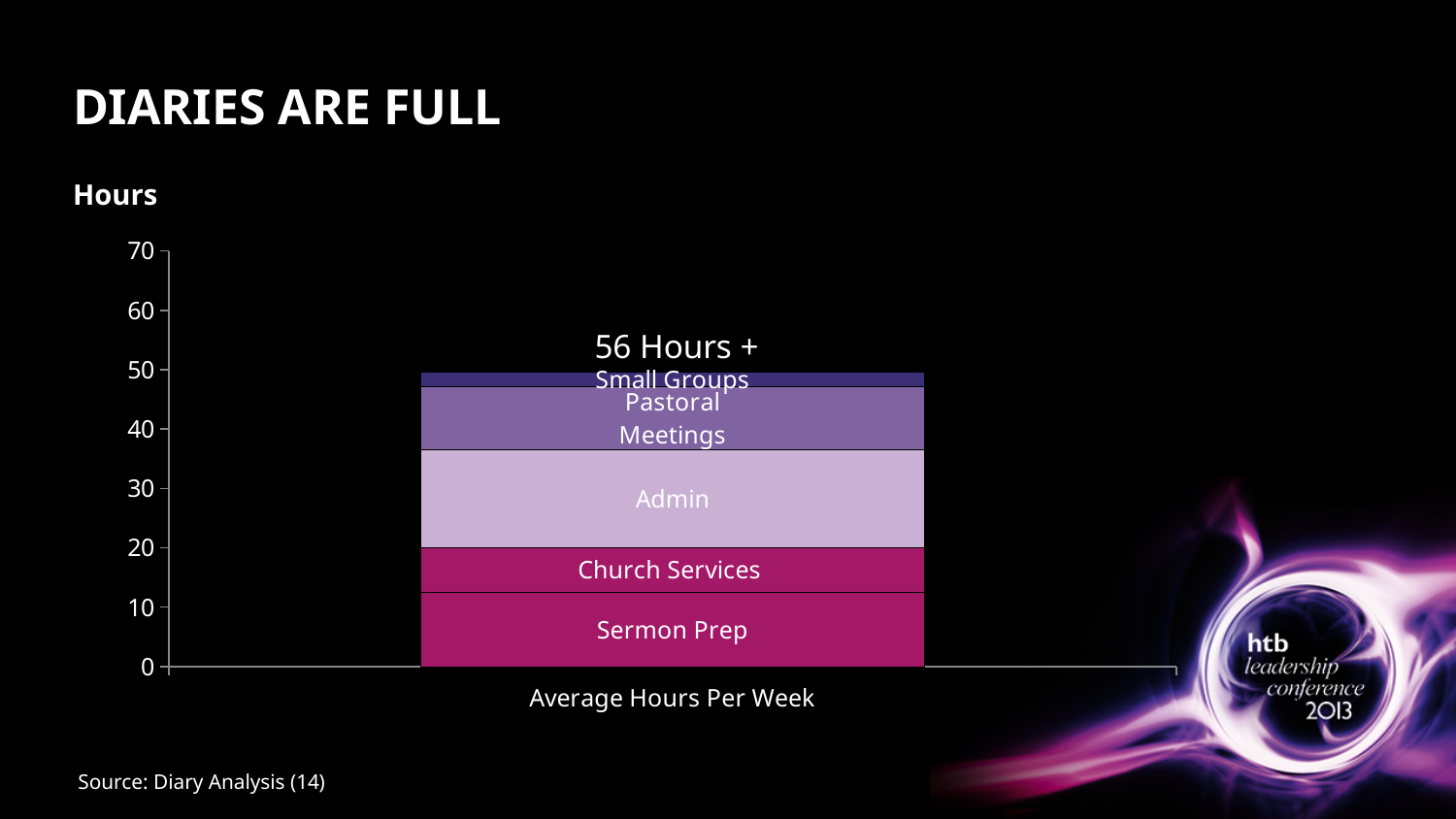
Which segment of the Average Hours Per Week bar is the largest? Admin Which segment is larger, Admin or Church Services? Admin Which segment is larger, Sermon Prep or Small Groups? Sermon Prep Is the total height of the Average Hours Per Week bar greater or less than 60? less What kind of chart is shown on the slide? Stacked bar chart What is the highest value shown on the vertical axis? 70 Is the total height of the Average Hours Per Week bar greater or less than 40? greater What annotation is printed above the stacked bar? 56 Hours + How many segments make up the stacked bar for Average Hours Per Week? 5 Which segment sits at the bottom of the stacked bar? Sermon Prep What is the category label on the horizontal axis? Average Hours Per Week Which segment of the Average Hours Per Week bar is the smallest? Small Groups